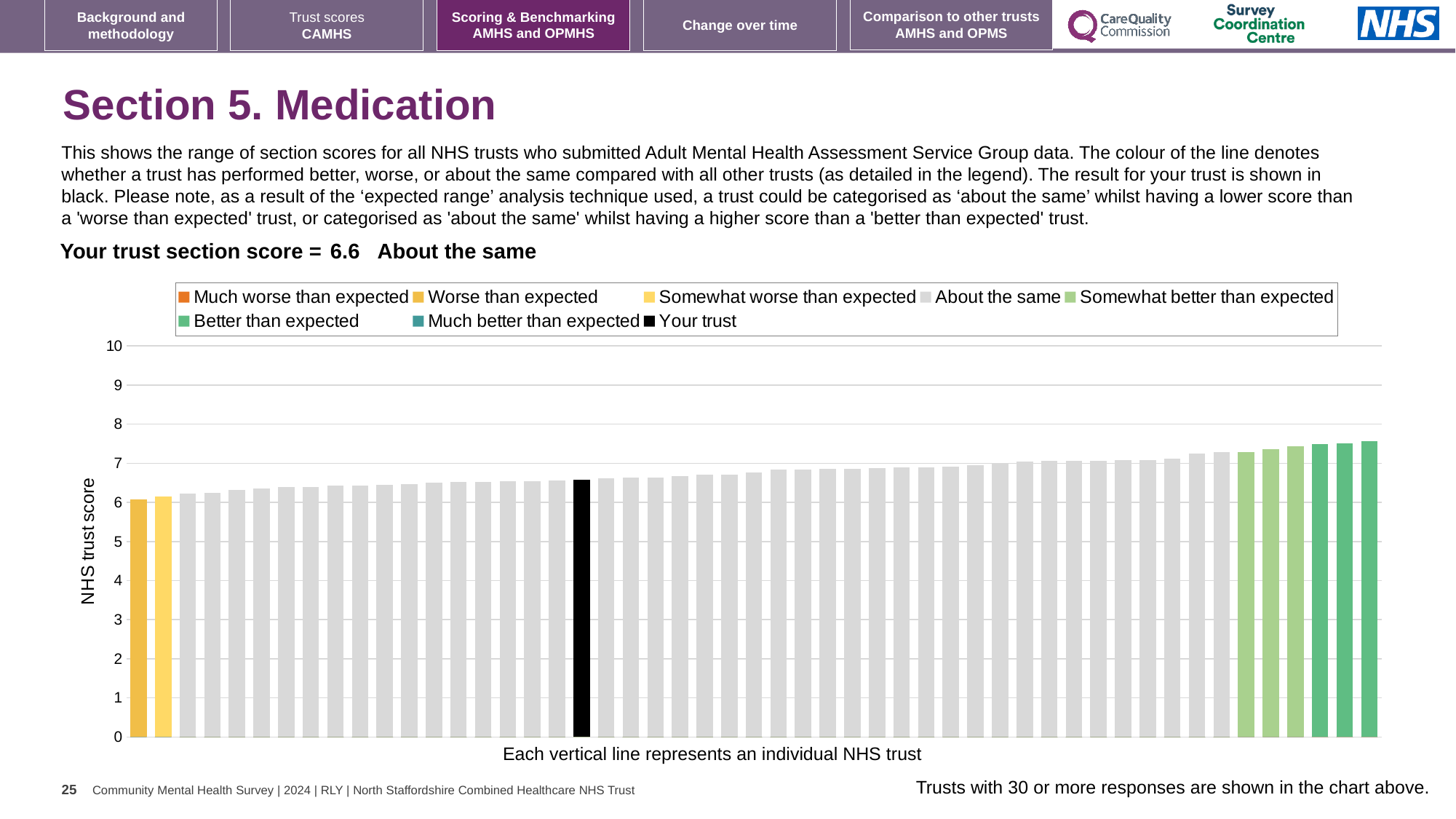
Which category does your trust's section score fall into according to the slide? About the same How many entries does the chart legend list? 8 What is the label on the vertical axis of the chart? NHS trust score Is the value of the black 'Your trust' bar greater or less than 5? greater Is the value of the black 'Your trust' bar greater or less than 8? less What is the section score for your trust shown on the slide? 6.6 What kind of chart is shown on the slide? bar chart Do the bar values rise or fall from left to right along the x axis? rise What colour is the bar representing your trust? black Is the value of the leftmost bar greater or less than 7? less What is the highest value shown on the vertical axis? 10